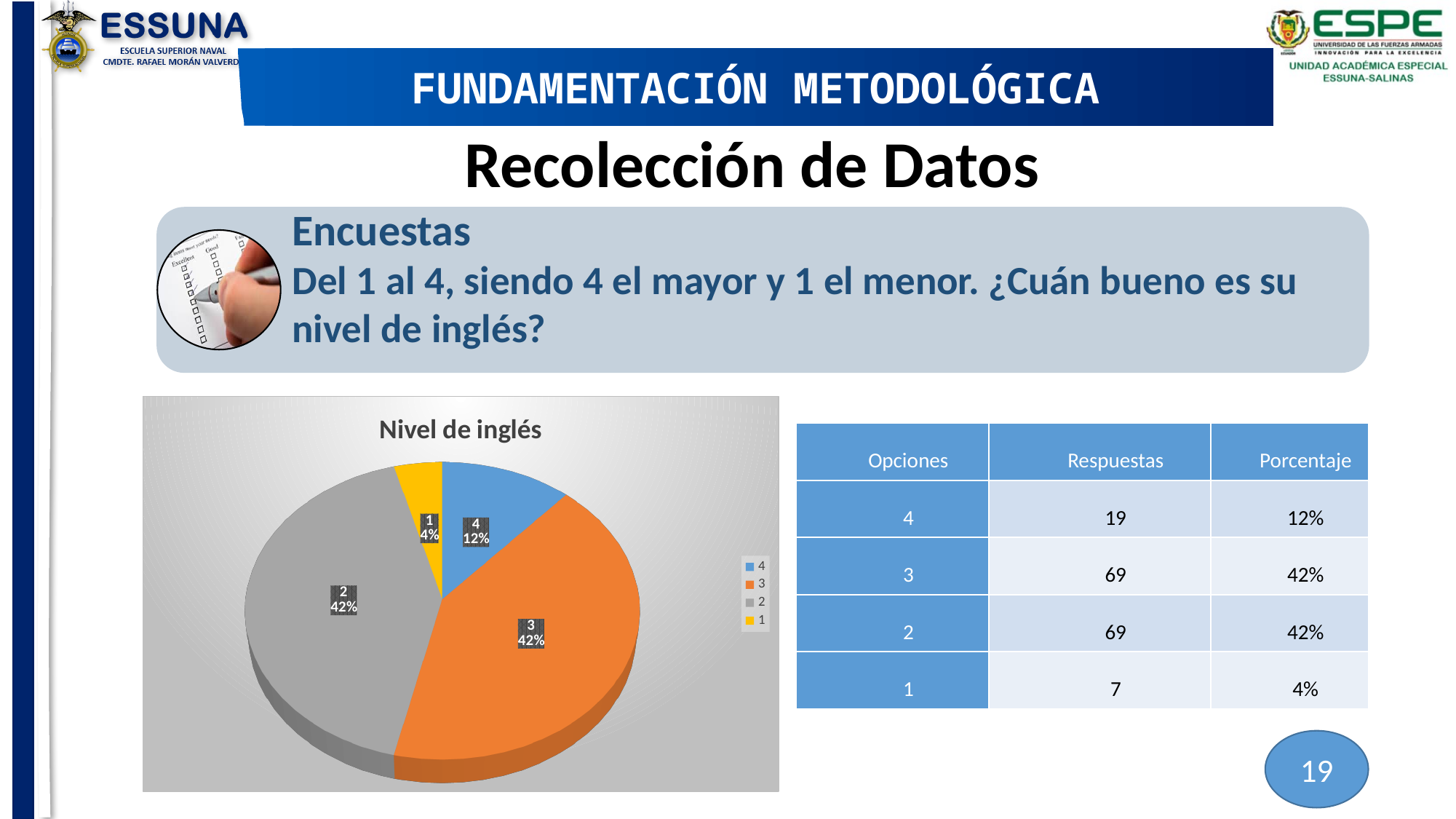
How many slices does the pie chart have? 4 What kind of chart is shown on the slide? pie chart What is the title of the chart? Nivel de inglés What share of the pie does category 3 represent? 42% Which slice is larger, category 3 or category 4? 3 Which category has the smallest slice of the pie? 1 What share of the pie does category 1 represent? 4% What share of the pie does category 4 represent? 12% How many entries does the chart legend list? 4 What is the difference in percentage points between the slice for category 4 and the slice for category 1? 8% Which slice is larger, category 4 or category 1? 4